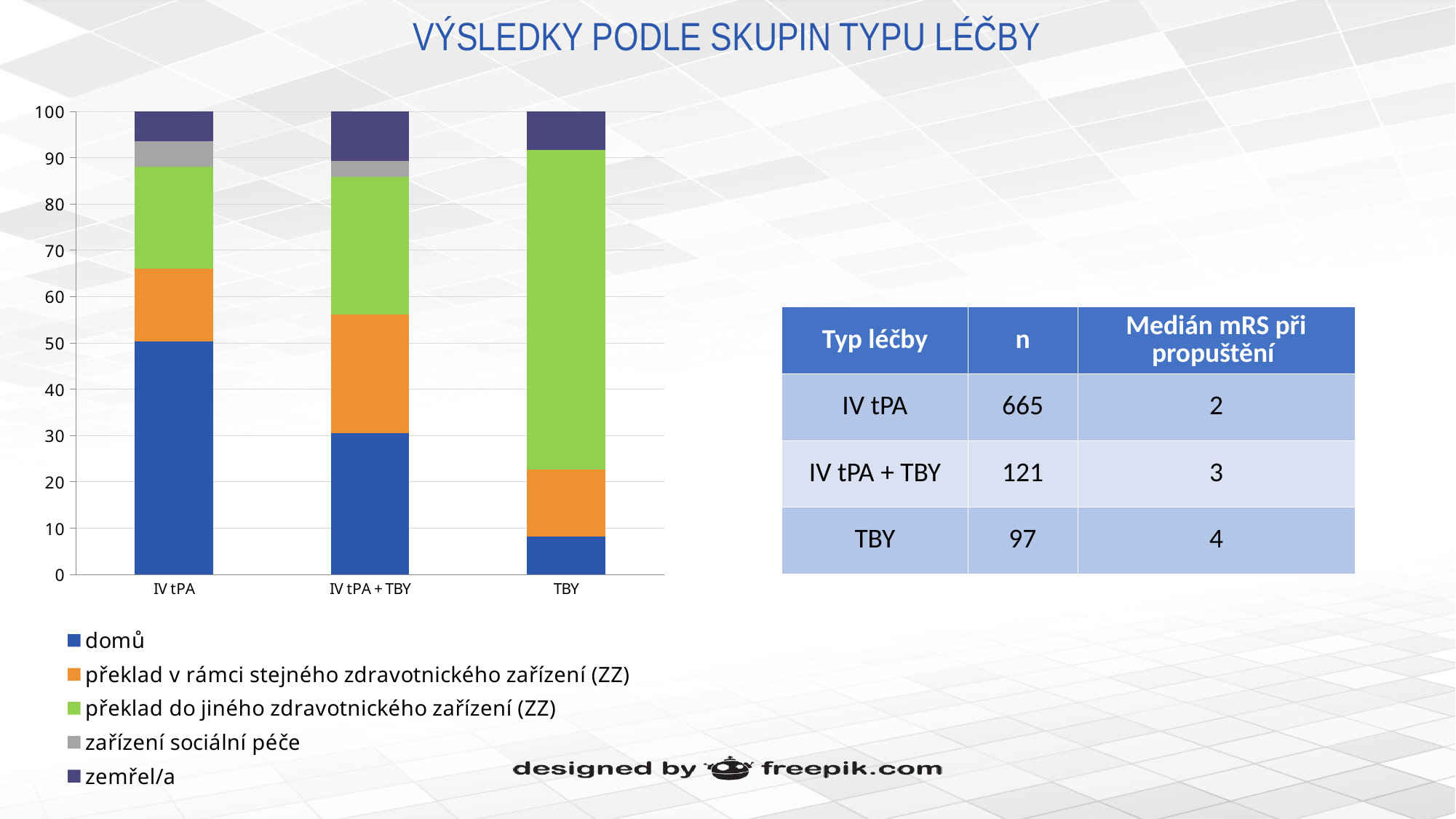
Which treatment group has the largest 'domů' segment? IV tPA Which treatment group has the largest 'překlad do jiného zdravotnického zařízení (ZZ)' segment? TBY Which treatment group has the smallest 'domů' segment? TBY What kind of chart is shown on the slide? stacked bar chart Is the 'domů' value for IV tPA + TBY greater or less than 40? less What is the total height of the stacked bar for IV tPA? 100 Which is larger, the 'domů' segment for IV tPA + TBY or for TBY? IV tPA + TBY How many treatment groups (categories) are shown on the x axis of the chart? 3 Does the 'domů' segment rise or fall moving from IV tPA to TBY along the x axis? fall Is the 'domů' value for IV tPA greater or less than 40? greater Is the 'domů' value for TBY greater or less than 10? less How many series does the chart legend list? 5